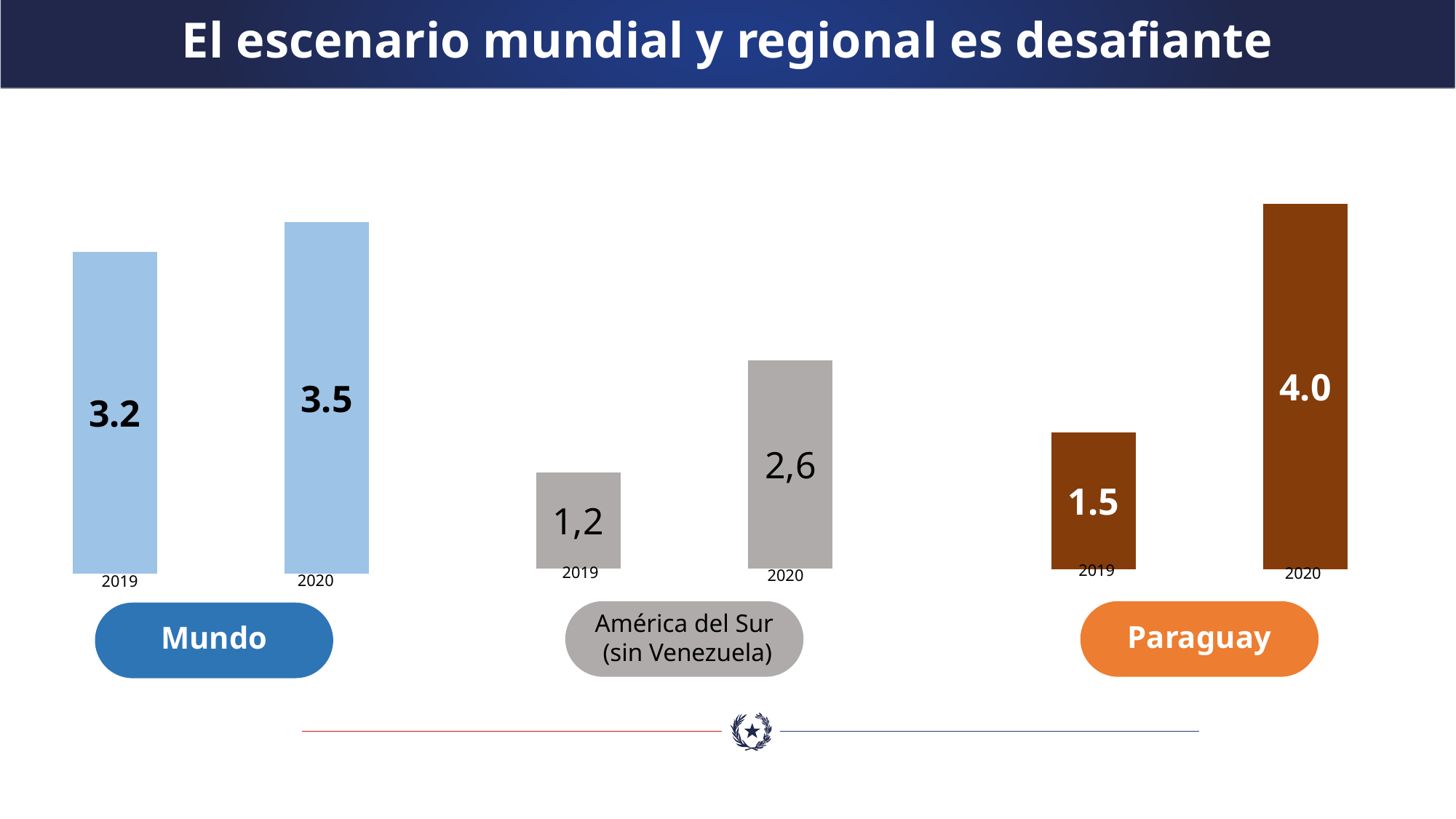
In the Mundo chart, what is the value for 2019? 3.2 In the Mundo chart, what is the difference between the 2020 and 2019 values? 0.3 In the Paraguay chart, what is the value for 2020? 4.0 In the Paraguay chart, what is the value for 2019? 1.5 In the América del Sur (sin Venezuela) chart, which year has the higher value? 2020 In the Paraguay chart, what is the difference between the 2020 and 2019 values? 2.5 In the Paraguay chart, do the values rise or fall from 2019 to 2020? rise In the Mundo chart, what is the value for 2020? 3.5 In the América del Sur (sin Venezuela) chart, what is the value for 2020? 2,6 How many bars does the Mundo chart have? 2 In the América del Sur (sin Venezuela) chart, what is the value for 2019? 1,2 What kind of chart is the Paraguay chart? bar chart